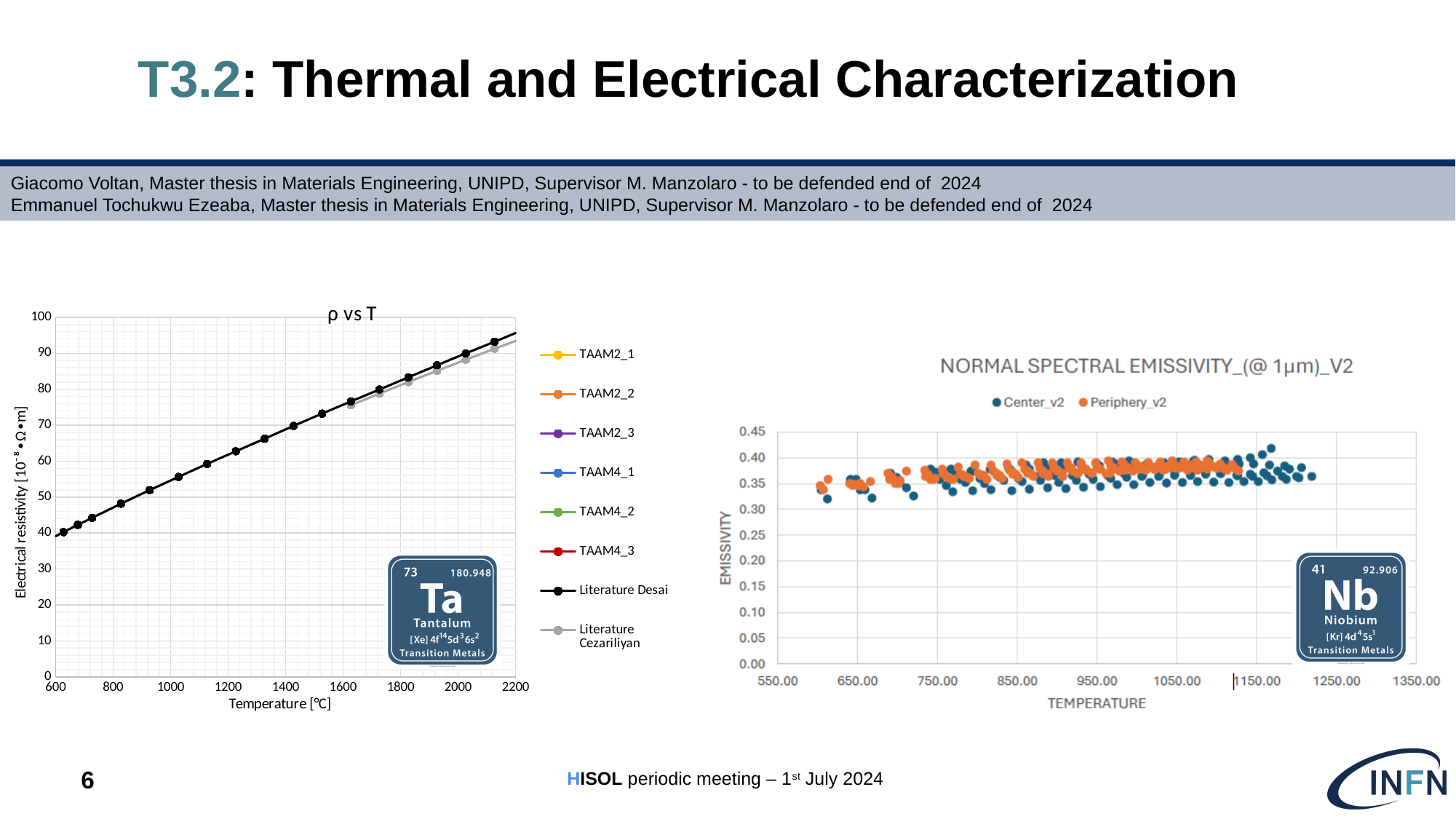
What is the title of the chart on the left of the slide? ρ vs T In the 'ρ vs T' chart, is the Literature Desai value at 2000 °C greater or less than 80? greater What kind of chart is the 'ρ vs T' chart? Line chart What is the title of the chart on the right of the slide? NORMAL SPECTRAL EMISSIVITY_(@ 1µm)_V2 In the 'NORMAL SPECTRAL EMISSIVITY_(@ 1µm)_V2' chart, how many series does the legend list? 2 In the 'NORMAL SPECTRAL EMISSIVITY_(@ 1µm)_V2' chart, are the plotted emissivity values greater or less than 0.30? greater In the 'ρ vs T' chart, how many series does the legend list? 8 In the 'ρ vs T' chart, is the Literature Desai value at 1200 °C greater or less than 60? greater In the 'NORMAL SPECTRAL EMISSIVITY_(@ 1µm)_V2' chart, which series generally shows higher emissivity values, Center_v2 or Periphery_v2? Periphery_v2 What kind of chart is the 'NORMAL SPECTRAL EMISSIVITY_(@ 1µm)_V2' chart? Scatter chart In the 'ρ vs T' chart, does the electrical resistivity rise or fall as temperature increases? Rises